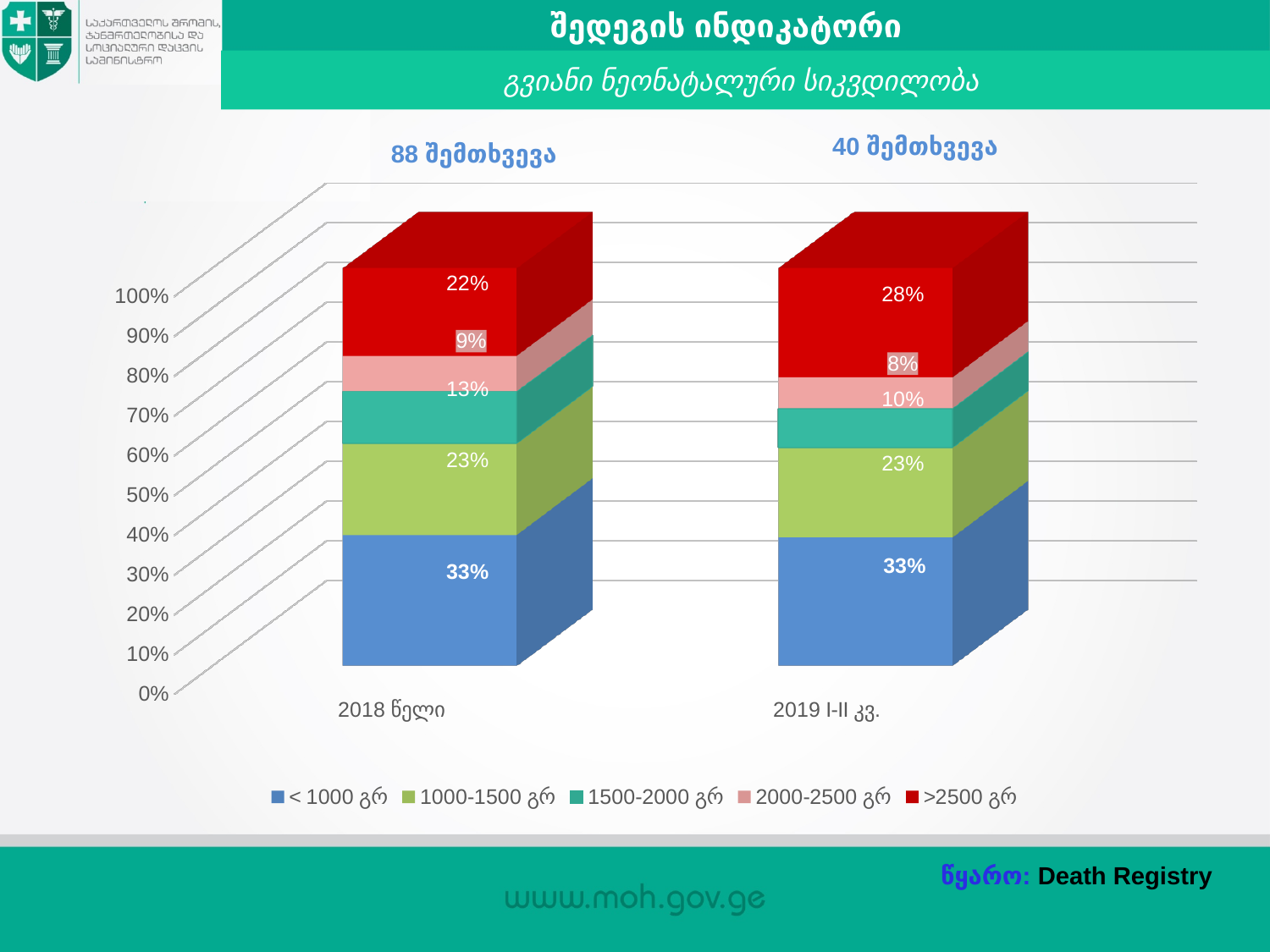
What is the value for the < 1000 გრ series in 2018 წელი? 33% Which is larger: the 1500-2000 გრ value in 2018 წელი or in 2019 I-II კვ.? 2018 წელი How many categories are shown on the x axis? 2 What is the value for the 1500-2000 გრ series in 2018 წელი? 13% Which series has the lowest value in 2019 I-II კვ.? 2000-2500 გრ How many series does the legend list? 5 What is the value for the 1000-1500 გრ series in 2019 I-II კვ.? 23% What kind of chart is shown on the slide? Stacked bar chart Which series has the highest value in 2018 წელი? < 1000 გრ What is the value for the 2000-2500 გრ series in 2019 I-II კვ.? 8% What is the value for the >2500 გრ series in 2019 I-II კვ.? 28% What is the difference between the >2500 გრ values for 2019 I-II კვ. and 2018 წელი? 6%